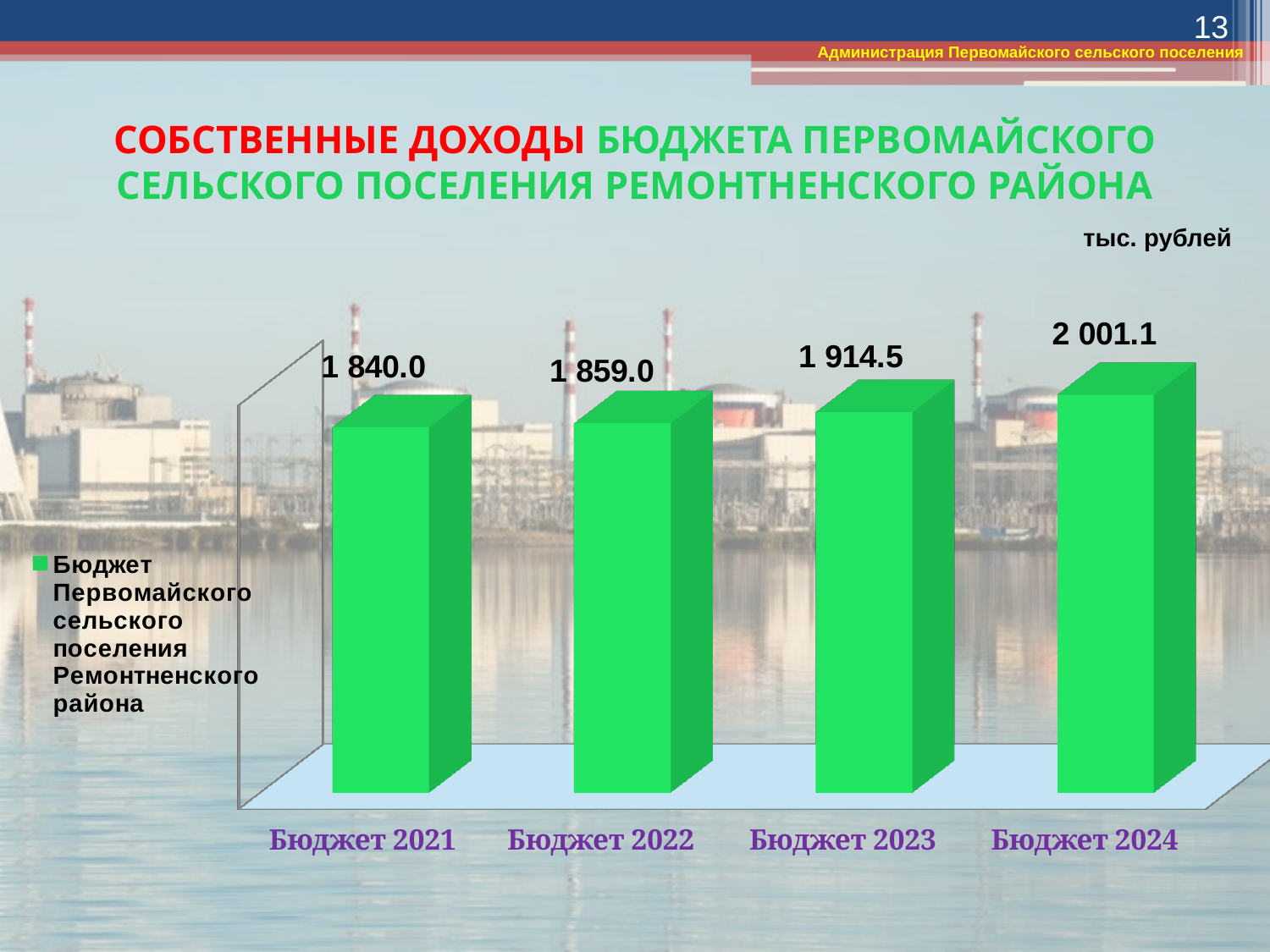
What kind of chart is shown on the slide? Bar chart What is the difference between the values for Бюджет 2023 and Бюджет 2022? 55.5 What is the value for Бюджет 2024? 2 001.1 Which is larger, the value for Бюджет 2022 or the value for Бюджет 2023? Бюджет 2023 What is the value for Бюджет 2023? 1 914.5 Which category has the lowest value? Бюджет 2021 Do the values rise or fall from Бюджет 2021 to Бюджет 2024? Rise What is the value for Бюджет 2021? 1 840.0 How many categories are shown on the chart? 4 What is the difference between the values for Бюджет 2024 and Бюджет 2021? 161.1 How many series does the legend list? 1 Which category has the highest value? Бюджет 2024